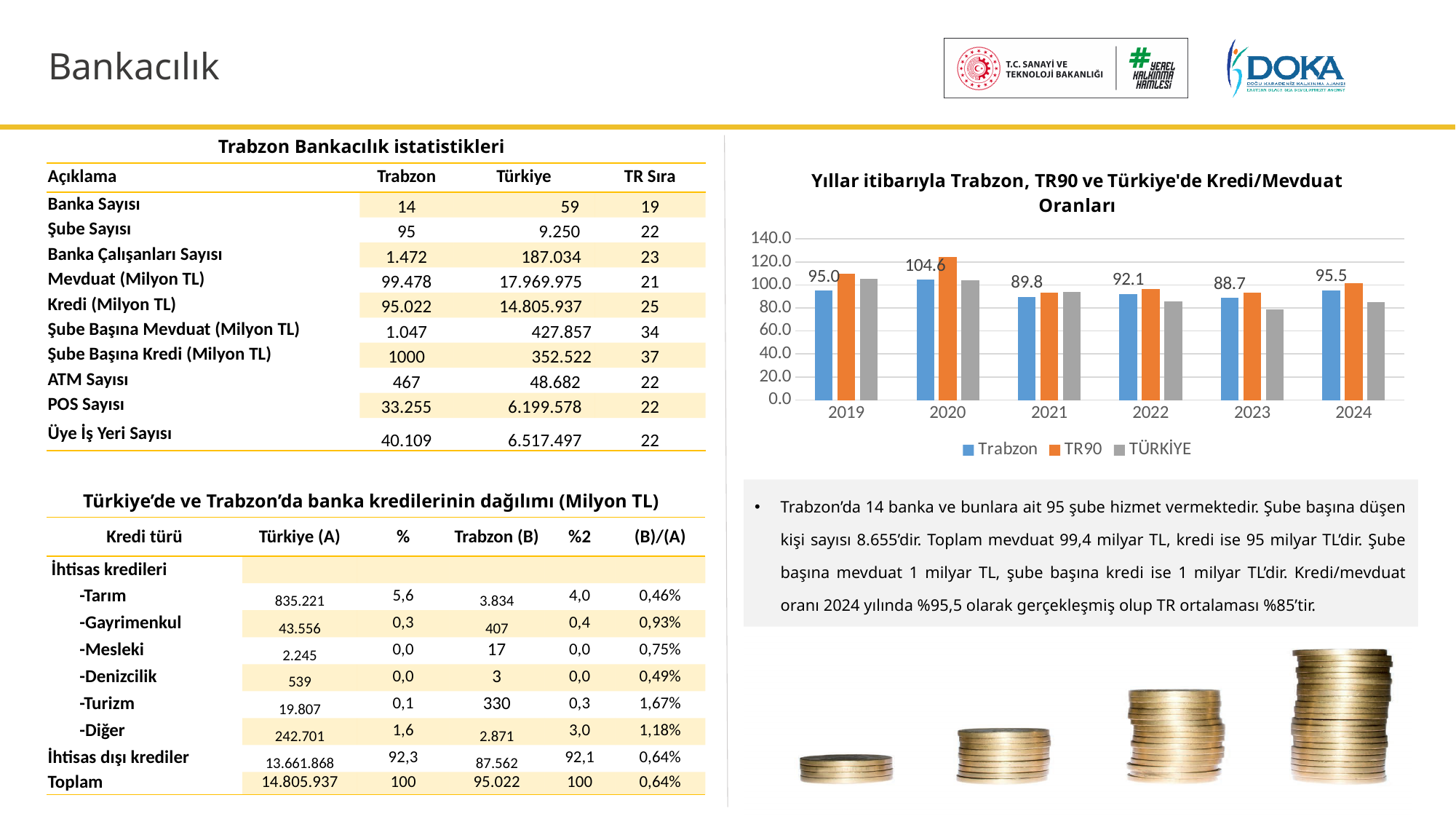
In the chart 'Yıllar itibarıyla Trabzon, TR90 ve Türkiye'de Kredi/Mevduat Oranları', in which year is the Trabzon value lowest? 2023 How many years are shown on the x axis of the chart 'Yıllar itibarıyla Trabzon, TR90 ve Türkiye'de Kredi/Mevduat Oranları'? 6 How many series does the legend of the chart 'Yıllar itibarıyla Trabzon, TR90 ve Türkiye'de Kredi/Mevduat Oranları' list? 3 In the chart 'Yıllar itibarıyla Trabzon, TR90 ve Türkiye'de Kredi/Mevduat Oranları', what is the Trabzon value for 2020? 104.6 In the chart 'Yıllar itibarıyla Trabzon, TR90 ve Türkiye'de Kredi/Mevduat Oranları', in which year is the Trabzon value highest? 2020 In the chart 'Yıllar itibarıyla Trabzon, TR90 ve Türkiye'de Kredi/Mevduat Oranları', what is the difference between the Trabzon values for 2020 and 2023? 15.9 In the chart 'Yıllar itibarıyla Trabzon, TR90 ve Türkiye'de Kredi/Mevduat Oranları', what is the Trabzon value for 2023? 88.7 In the chart 'Yıllar itibarıyla Trabzon, TR90 ve Türkiye'de Kredi/Mevduat Oranları', what is the Trabzon value for 2024? 95.5 In the chart 'Yıllar itibarıyla Trabzon, TR90 ve Türkiye'de Kredi/Mevduat Oranları', is the TÜRKİYE value for 2024 greater or less than 100.0? less In the chart 'Yıllar itibarıyla Trabzon, TR90 ve Türkiye'de Kredi/Mevduat Oranları', is the TR90 value for 2020 greater or less than 120.0? greater What kind of chart is 'Yıllar itibarıyla Trabzon, TR90 ve Türkiye'de Kredi/Mevduat Oranları'? bar chart In the chart 'Yıllar itibarıyla Trabzon, TR90 ve Türkiye'de Kredi/Mevduat Oranları', which year has the larger Trabzon value, 2019 or 2022? 2019